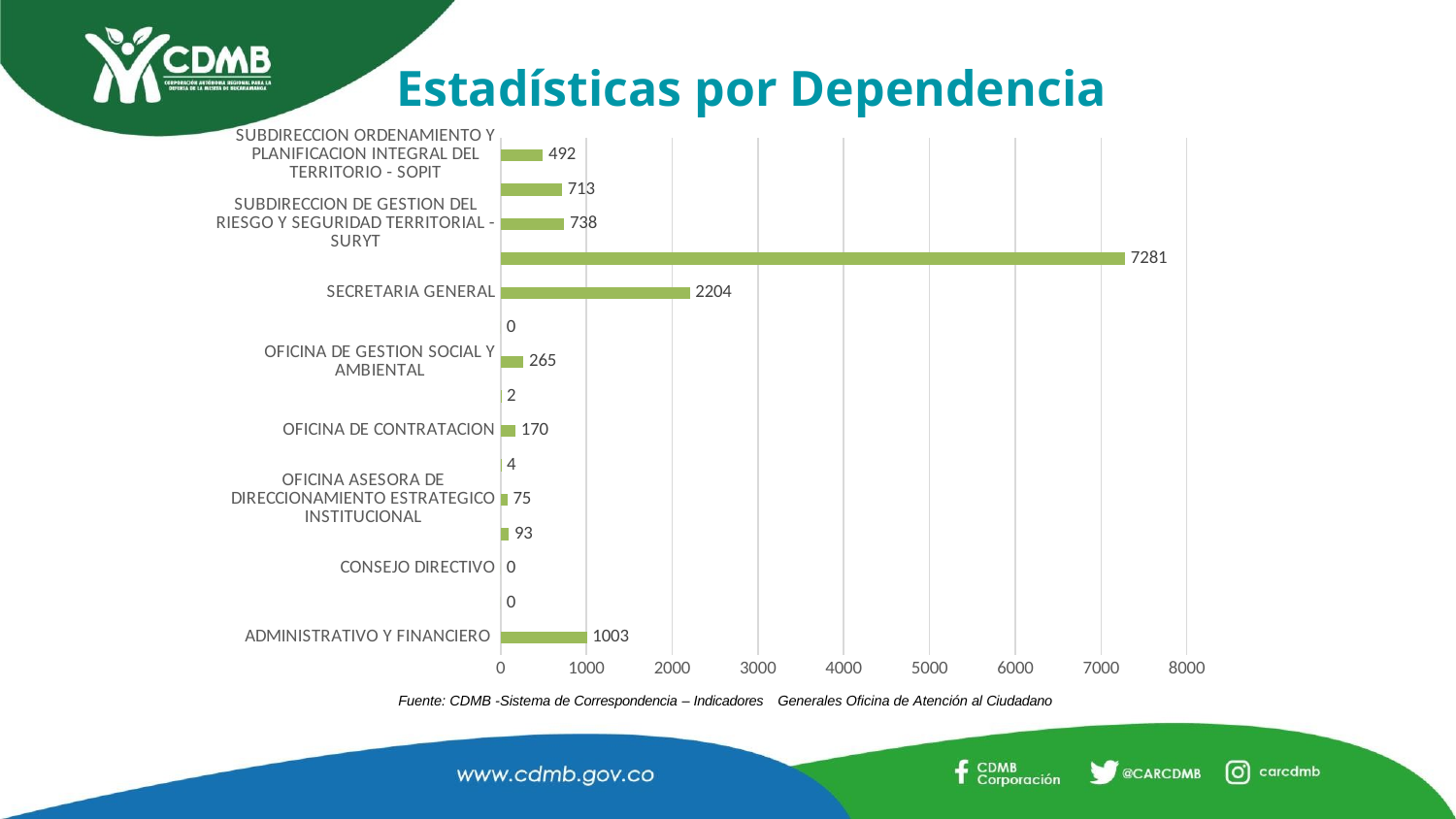
Is the value for SECRETARIA GENERAL greater or less than 2000? greater What is the value for OFICINA DE GESTION SOCIAL Y AMBIENTAL? 265 Which is larger, the value for OFICINA DE GESTION SOCIAL Y AMBIENTAL or the value for OFICINA DE CONTRATACION? OFICINA DE GESTION SOCIAL Y AMBIENTAL What is the largest value labelled on any bar in the chart? 7281 What is the value for ADMINISTRATIVO Y FINANCIERO? 1003 What is the value for CONSEJO DIRECTIVO? 0 What kind of chart is shown on the slide? bar chart What is the value for OFICINA DE CONTRATACION? 170 What is the value for SUBDIRECCION DE GESTION DEL RIESGO Y SEGURIDAD TERRITORIAL - SURYT? 738 What is the value for SECRETARIA GENERAL? 2204 How many bars are plotted in the chart? 15 What is the difference between the values for SECRETARIA GENERAL and ADMINISTRATIVO Y FINANCIERO? 1201